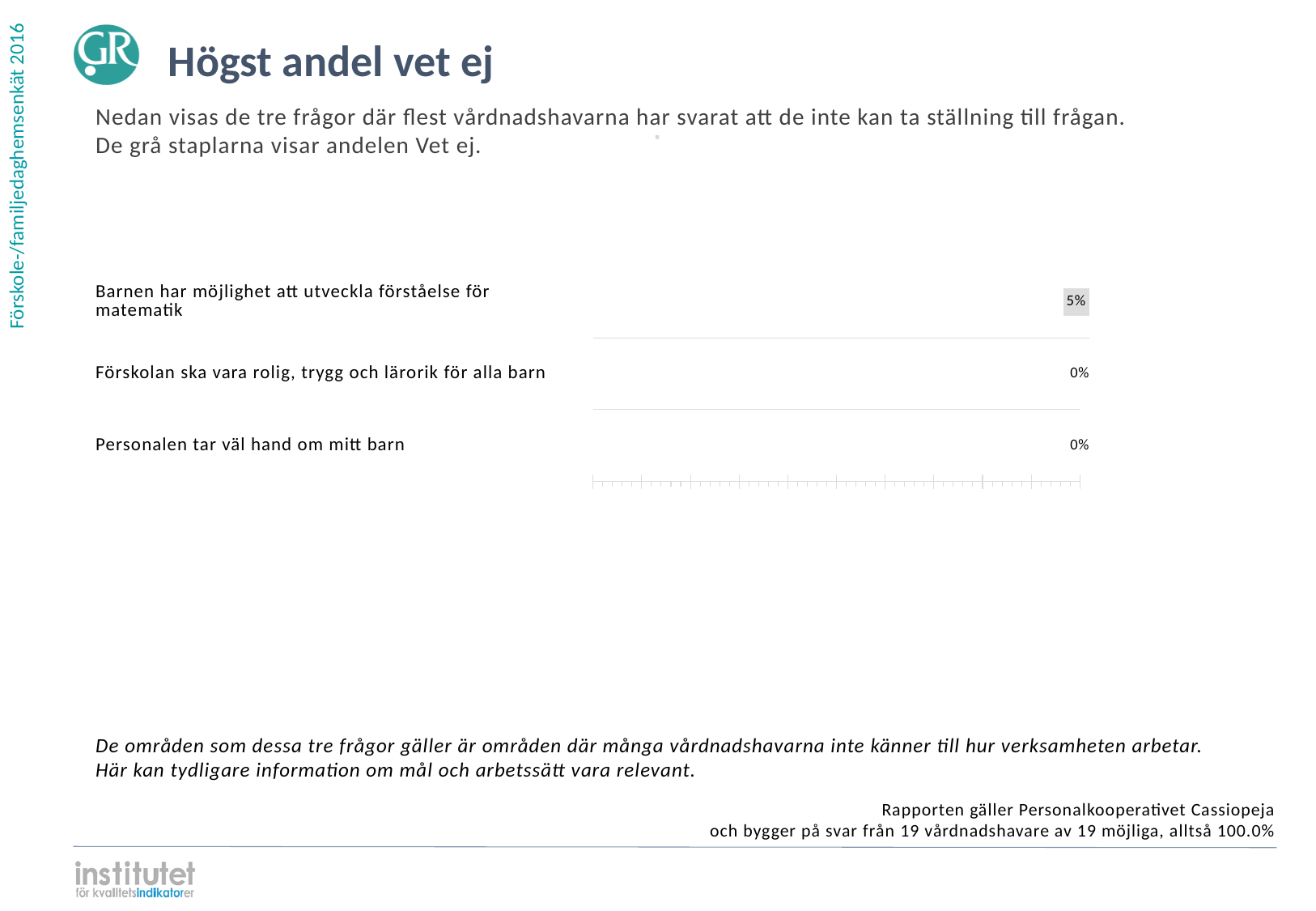
What is the Vet ej share for "Personalen tar väl hand om mitt barn"? 0% What kind of chart is shown on the slide? Bar chart What is the title of the slide containing the chart? Högst andel vet ej What is the Vet ej share for "Förskolan ska vara rolig, trygg och lärorik för alla barn"? 0% What is the Vet ej share for "Barnen har möjlighet att utveckla förståelse för matematik"? 5% How many of the three questions have a Vet ej share of 0%? 2 According to the slide text, what colour are the bars that show the share of Vet ej? Grey Which has a larger Vet ej share: "Barnen har möjlighet att utveckla förståelse för matematik" or "Förskolan ska vara rolig, trygg och lärorik för alla barn"? Barnen har möjlighet att utveckla förståelse för matematik What is the difference between the Vet ej share for "Barnen har möjlighet att utveckla förståelse för matematik" and for "Personalen tar väl hand om mitt barn"? 5% How many questions (categories) are shown in the chart? 3 Which question has the highest share of Vet ej answers? Barnen har möjlighet att utveckla förståelse för matematik